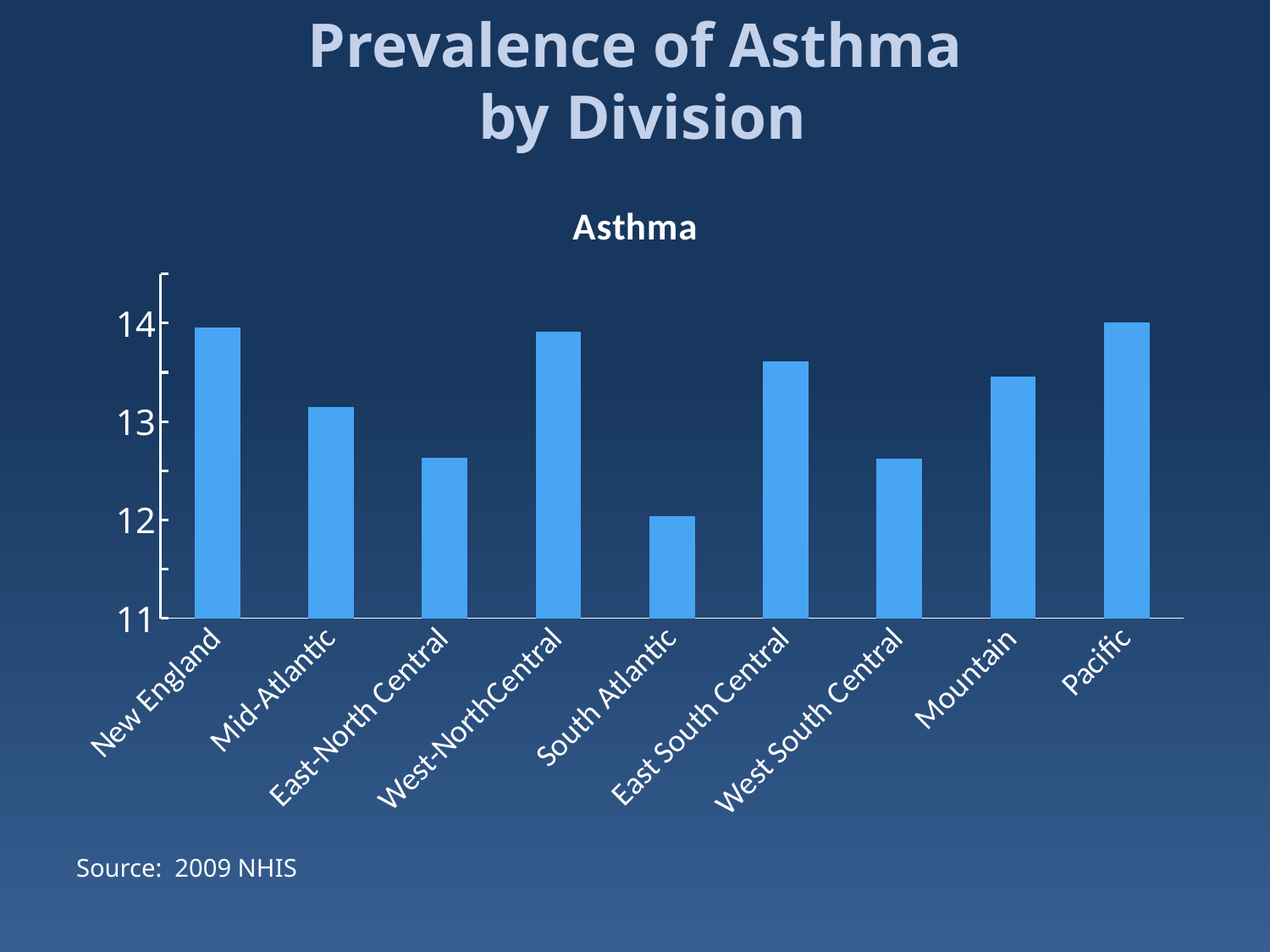
What is the title shown directly above the chart? Asthma What source is cited for the chart data? 2009 NHIS Which division has the lowest asthma prevalence in the chart? South Atlantic How many divisions are shown on the x axis of the chart? 9 Is the value for East South Central greater or less than 13? greater Which has the larger value, East South Central or West South Central? East South Central Which has the larger value, Mid-Atlantic or South Atlantic? Mid-Atlantic Is the value for South Atlantic greater or less than 13? less What kind of chart is shown on the slide? bar chart Is the value for East-North Central greater or less than 13? less